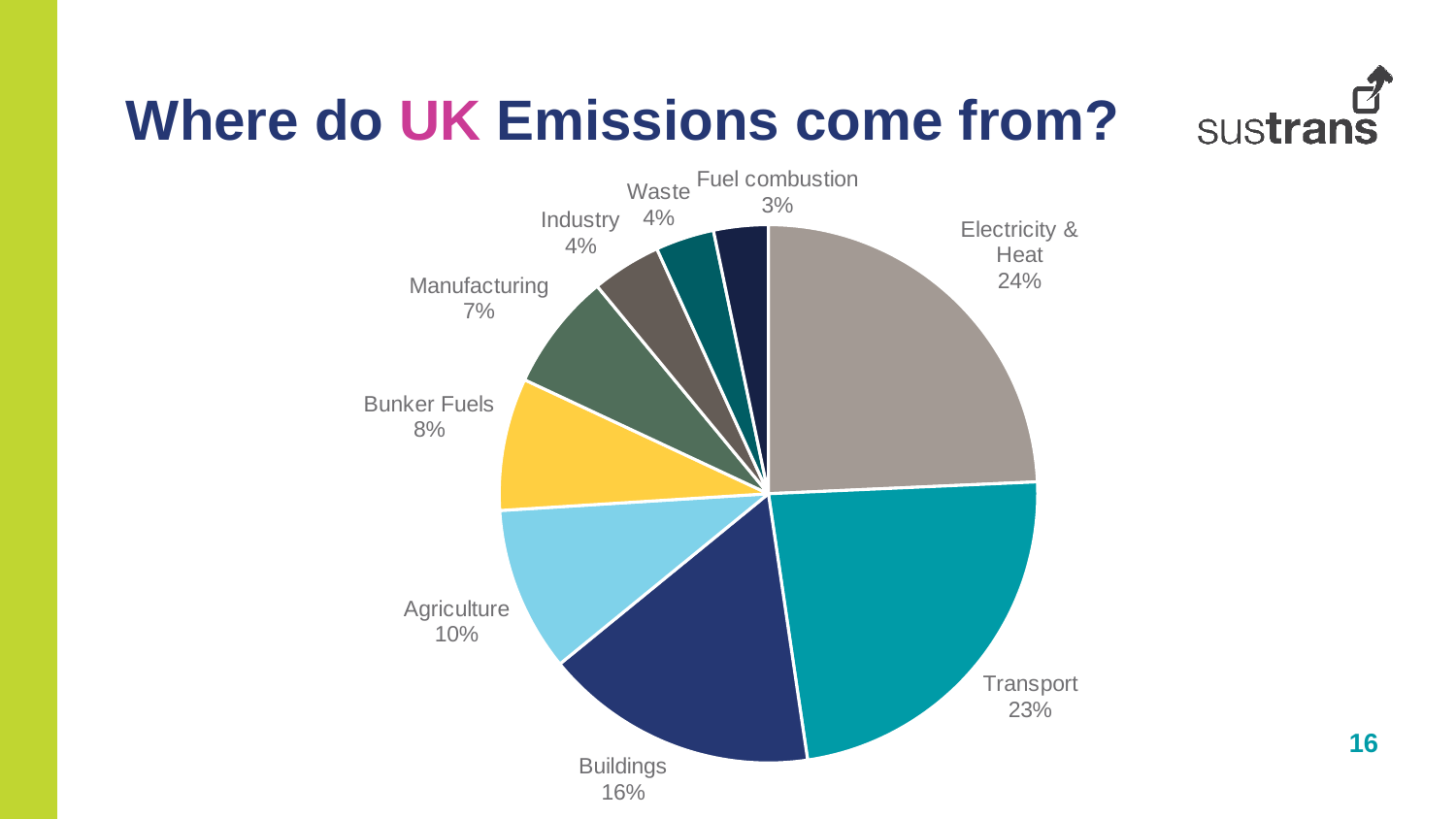
What percentage is shown for Agriculture? 10% How many categories are shown in the pie chart? 9 Which category has the largest share of UK emissions? Electricity & Heat What is the combined share of Electricity & Heat and Transport? 47% What is the difference in percentage points between Electricity & Heat and Buildings? 8 What kind of chart is shown on the slide? pie chart What is the title of the slide containing the pie chart? Where do UK Emissions come from? What is the value shown for Bunker Fuels? 8% Which is larger, the share for Agriculture or the share for Manufacturing? Agriculture What percentage of emissions is attributed to Buildings? 16% Which category has the smallest share of UK emissions? Fuel combustion What share of UK emissions comes from Transport? 23%